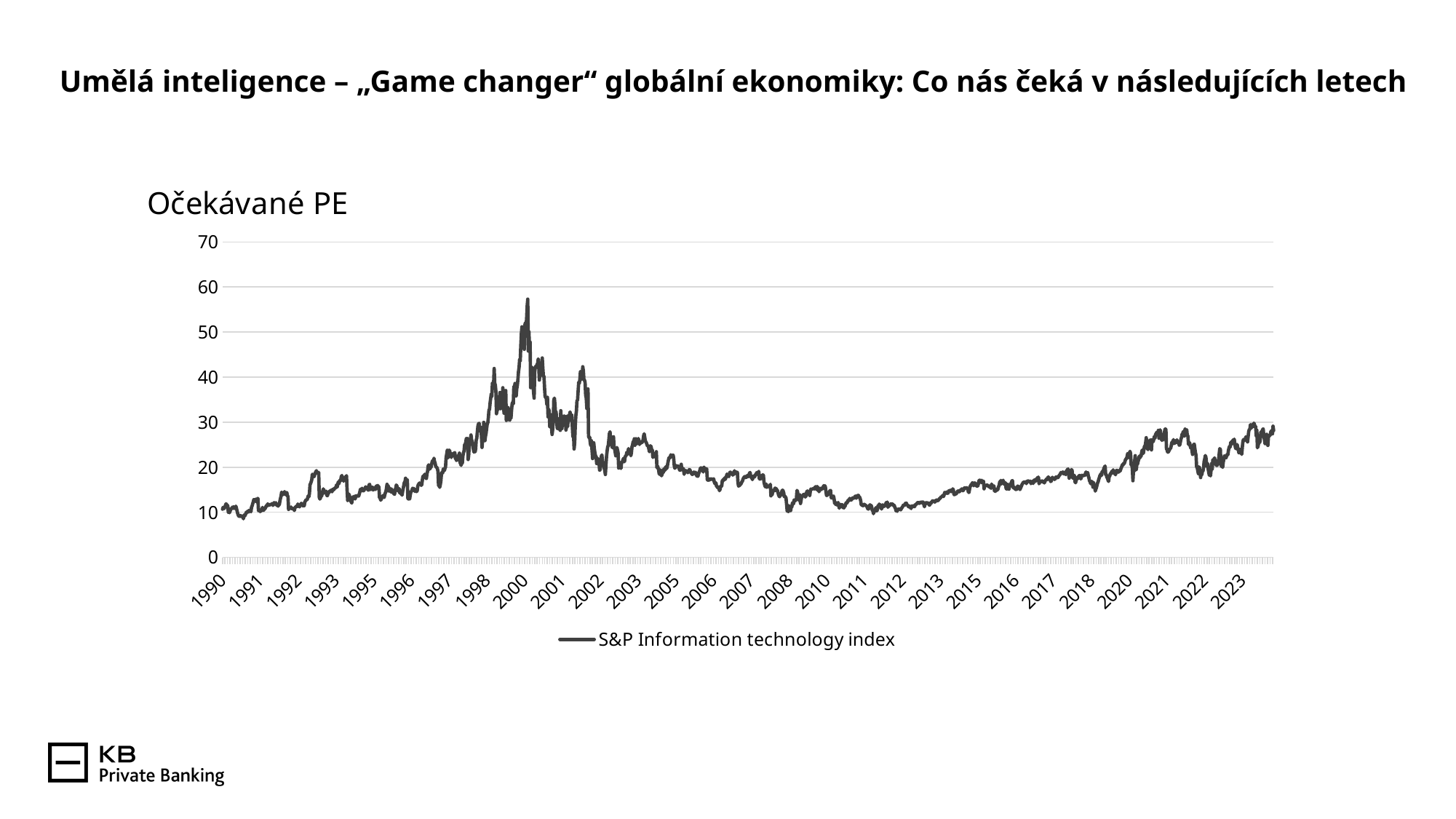
Does the line generally rise or fall between 2011 and 2023? rise Is the peak value of the line around 2000 greater or less than 50? greater What series name is shown in the legend? S&P Information technology index Is the value for 2011 greater or less than 20? less Does the line generally rise or fall between 2000 and 2008? fall Is the value for 1990 greater or less than 20? less Around which year does the S&P Information technology index reach its highest value? 2000 What is the title of the chart? Očekávané PE What kind of chart is shown on the slide? line chart How many series does the legend list? 1 How many year labels are shown on the x axis? 28